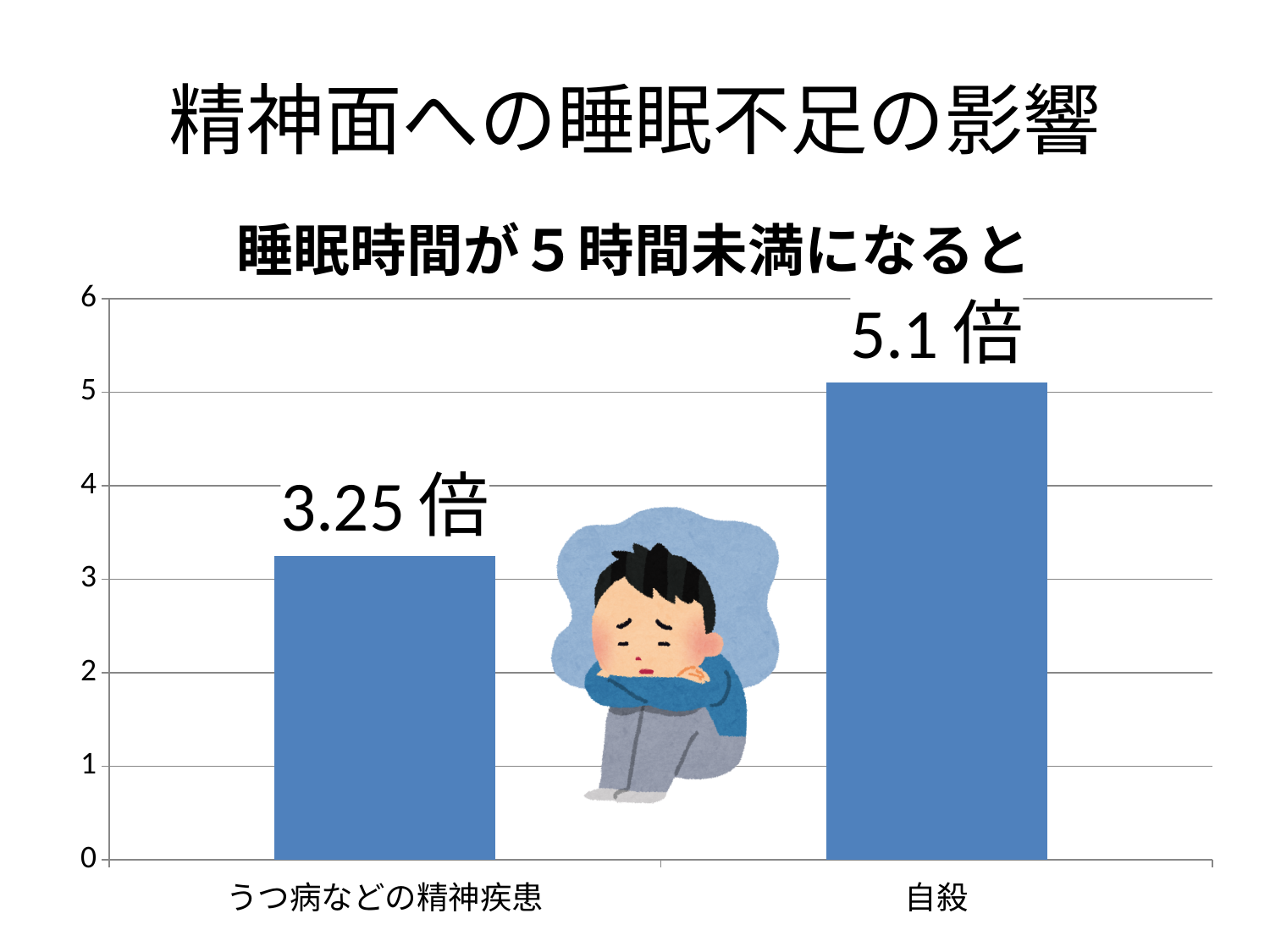
Is the value for うつ病などの精神疾患 greater or less than 3? greater Which category has the highest value? 自殺 How many categories are shown in the chart? 2 What is the value for うつ病などの精神疾患? 3.25 倍 What is the difference between the values for 自殺 and うつ病などの精神疾患? 1.85 倍 What is the maximum value shown on the vertical axis? 6 What is the value for 自殺? 5.1 倍 Which category has the lowest value? うつ病などの精神疾患 Is the value for 自殺 greater or less than 6? less Which is larger, the value for 自殺 or the value for うつ病などの精神疾患? 自殺 What is the title of the chart? 睡眠時間が５時間未満になると What kind of chart is shown on the slide? bar chart